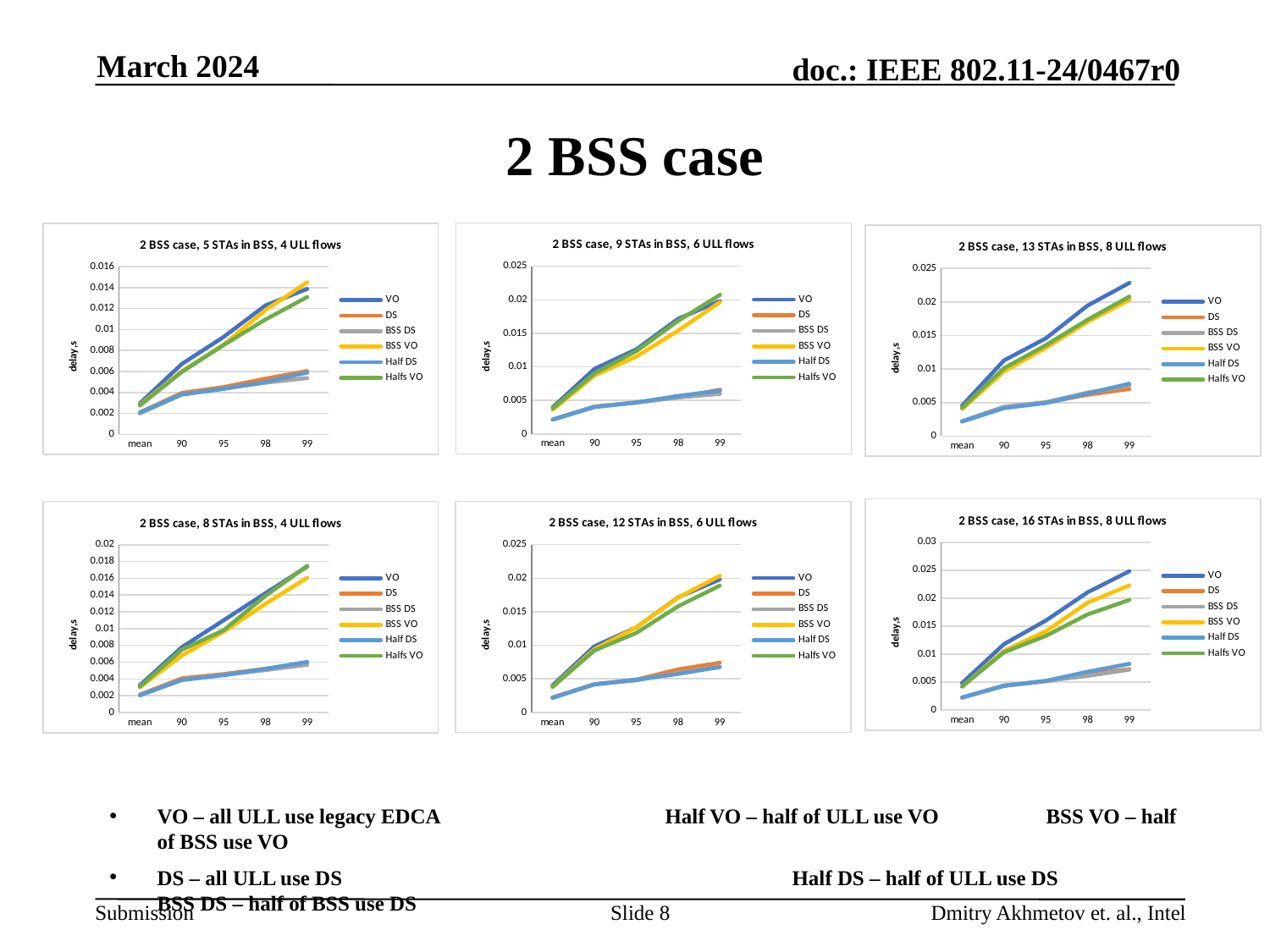
What is the y-axis label of the chart titled "2 BSS case, 8 STAs in BSS, 4 ULL flows"? delay,s In the chart titled "2 BSS case, 16 STAs in BSS, 8 ULL flows", is the VO value at 99 greater or less than 0.02? greater How many categories are shown on the x axis of the chart titled "2 BSS case, 13 STAs in BSS, 8 ULL flows"? 5 In the chart titled "2 BSS case, 12 STAs in BSS, 6 ULL flows", which is larger at 99: the VO value or the DS value? VO In the chart titled "2 BSS case, 8 STAs in BSS, 4 ULL flows", do the VO values rise or fall from "mean" to "99"? rise In the chart titled "2 BSS case, 16 STAs in BSS, 8 ULL flows", which series has the highest value at 99? VO In the chart titled "2 BSS case, 5 STAs in BSS, 4 ULL flows", is the VO value at 99 greater or less than 0.012? greater In the chart titled "2 BSS case, 9 STAs in BSS, 6 ULL flows", is the DS value at 99 greater or less than 0.01? less What kind of chart is the top-left chart titled "2 BSS case, 5 STAs in BSS, 4 ULL flows"? line chart What is the title of the bottom-right chart on the slide? 2 BSS case, 16 STAs in BSS, 8 ULL flows How many series does the legend list in the chart titled "2 BSS case, 9 STAs in BSS, 6 ULL flows"? 6 In the chart titled "2 BSS case, 13 STAs in BSS, 8 ULL flows", which series has the highest value at 99? VO